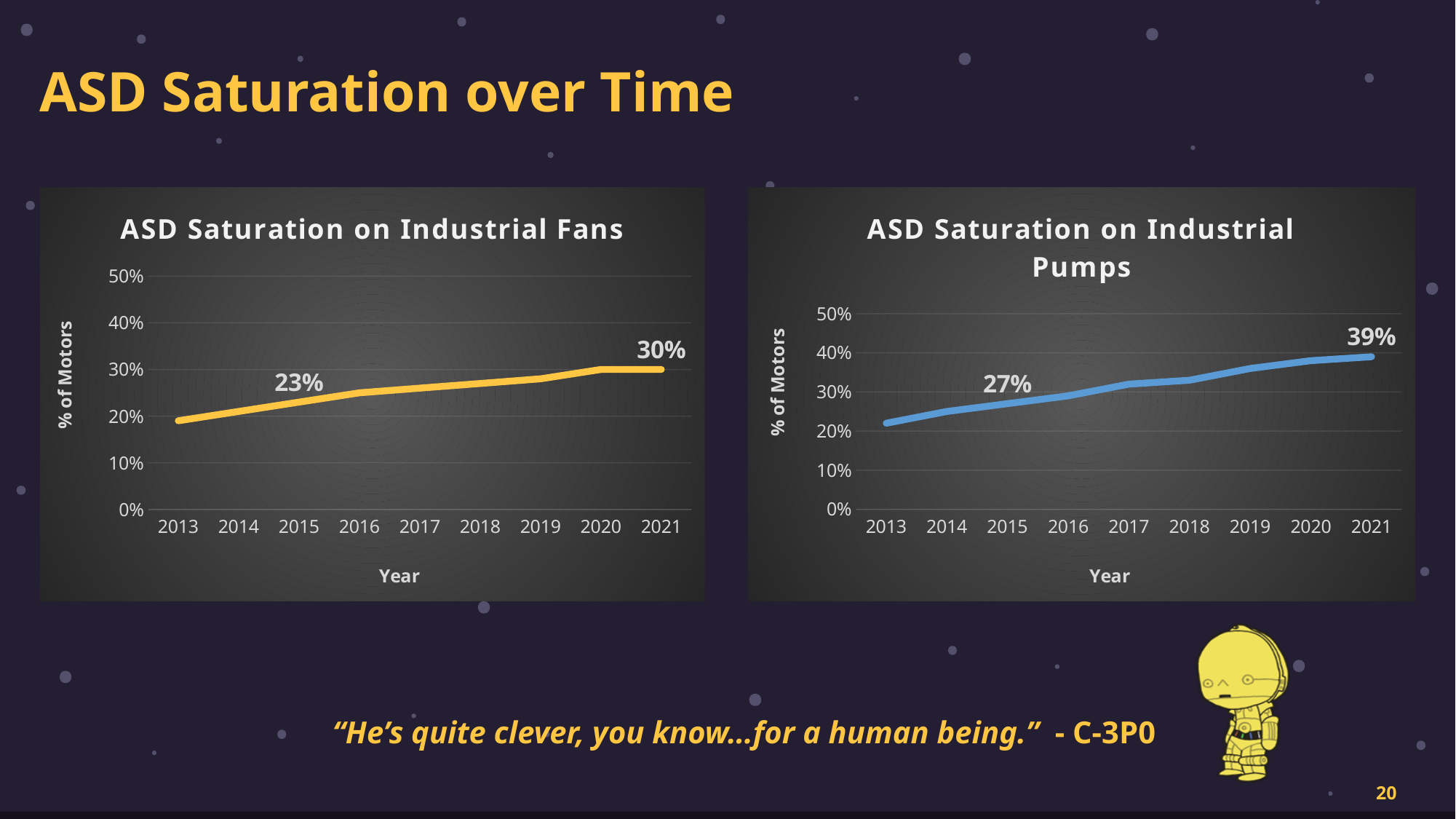
In the 'ASD Saturation on Industrial Pumps' chart, what is the value for 2021? 39% In the 'ASD Saturation on Industrial Fans' chart, what is the labelled value for 2015? 23% In the 'ASD Saturation on Industrial Pumps' chart, is the value for 2013 greater or less than 20%? greater In the 'ASD Saturation on Industrial Fans' chart, what is the value for 2021? 30% In the 'ASD Saturation on Industrial Fans' chart, do the values rise or fall from 2013 to 2021? Rise In the 'ASD Saturation on Industrial Pumps' chart, what is the difference between the 2021 value and the 2015 value? 12% Which is larger: the 2021 value in the 'ASD Saturation on Industrial Fans' chart or the 2021 value in the 'ASD Saturation on Industrial Pumps' chart? Industrial Pumps (39%) How many years are plotted on the x axis of the 'ASD Saturation on Industrial Fans' chart? 9 In the 'ASD Saturation on Industrial Pumps' chart, what is the labelled value for 2015? 27% What kind of chart is 'ASD Saturation on Industrial Pumps'? Line chart In the 'ASD Saturation on Industrial Fans' chart, what is the difference between the 2021 value and the 2015 value? 7%